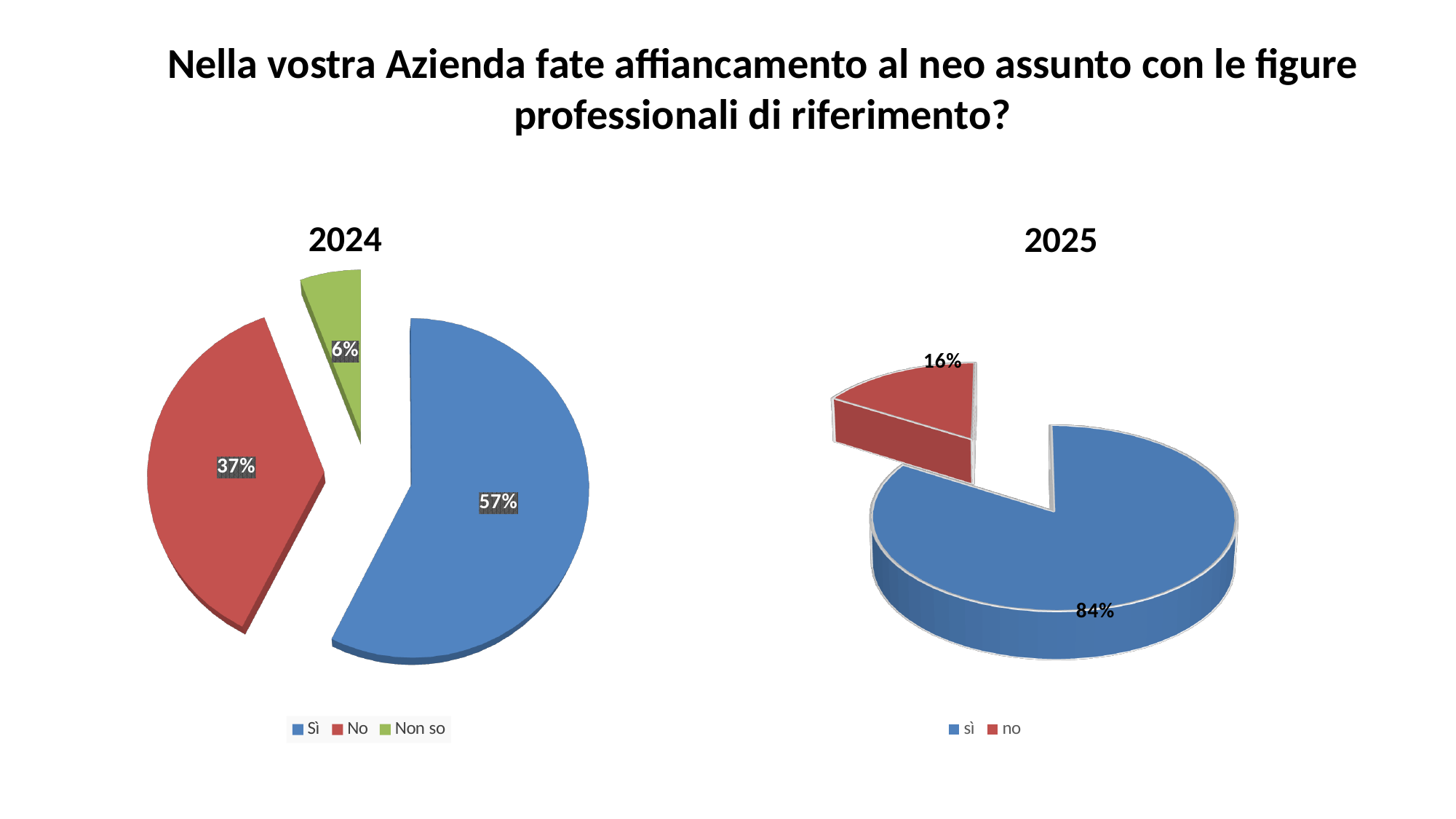
In the 2025 pie chart, what share is labelled for "sì"? 84% In the 2024 pie chart, which category has the largest slice? Sì What type of chart is used for the 2025 data? Pie chart How many entries does the legend of the 2025 pie chart list? 2 In the 2024 pie chart, what share is labelled for "Non so"? 6% In the 2025 pie chart, what is the difference in percentage points between "sì" and "no"? 68 In the 2024 pie chart, which category has the smallest slice? Non so In the 2024 pie chart, what is the difference in percentage points between "Sì" and "No"? 20 How many slices does the 2024 pie chart have? 3 In the 2025 pie chart, what share is labelled for "no"? 16% In the 2024 pie chart, what share is labelled for "Sì"? 57% In the 2024 pie chart, what share is labelled for "No"? 37%